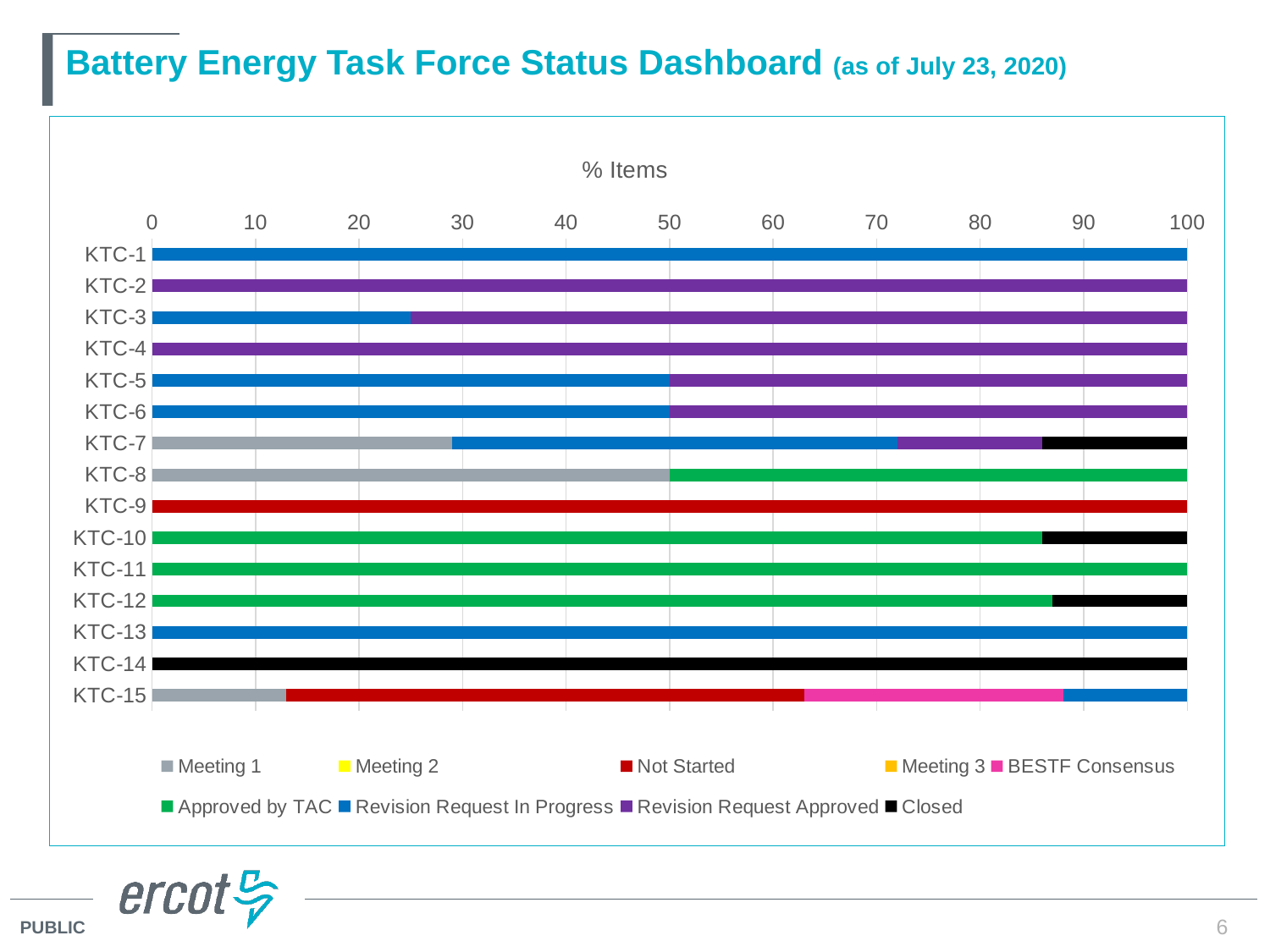
Is the Revision Request In Progress value for KTC-3 greater or less than 30? less What is the Not Started value for KTC-9? 100 What is the Revision Request In Progress value for KTC-1? 100 Is the Approved by TAC value for KTC-10 greater or less than 80? greater What kind of chart is shown on the slide? stacked bar chart What is the Meeting 1 value for KTC-8? 50 Which colour represents the Closed series in the legend? black How many KTC categories are plotted on the chart? 15 How many series does the chart legend list? 9 What is the Closed value for KTC-14? 100 What is the title of the chart? % Items What is the Revision Request In Progress value for KTC-5? 50